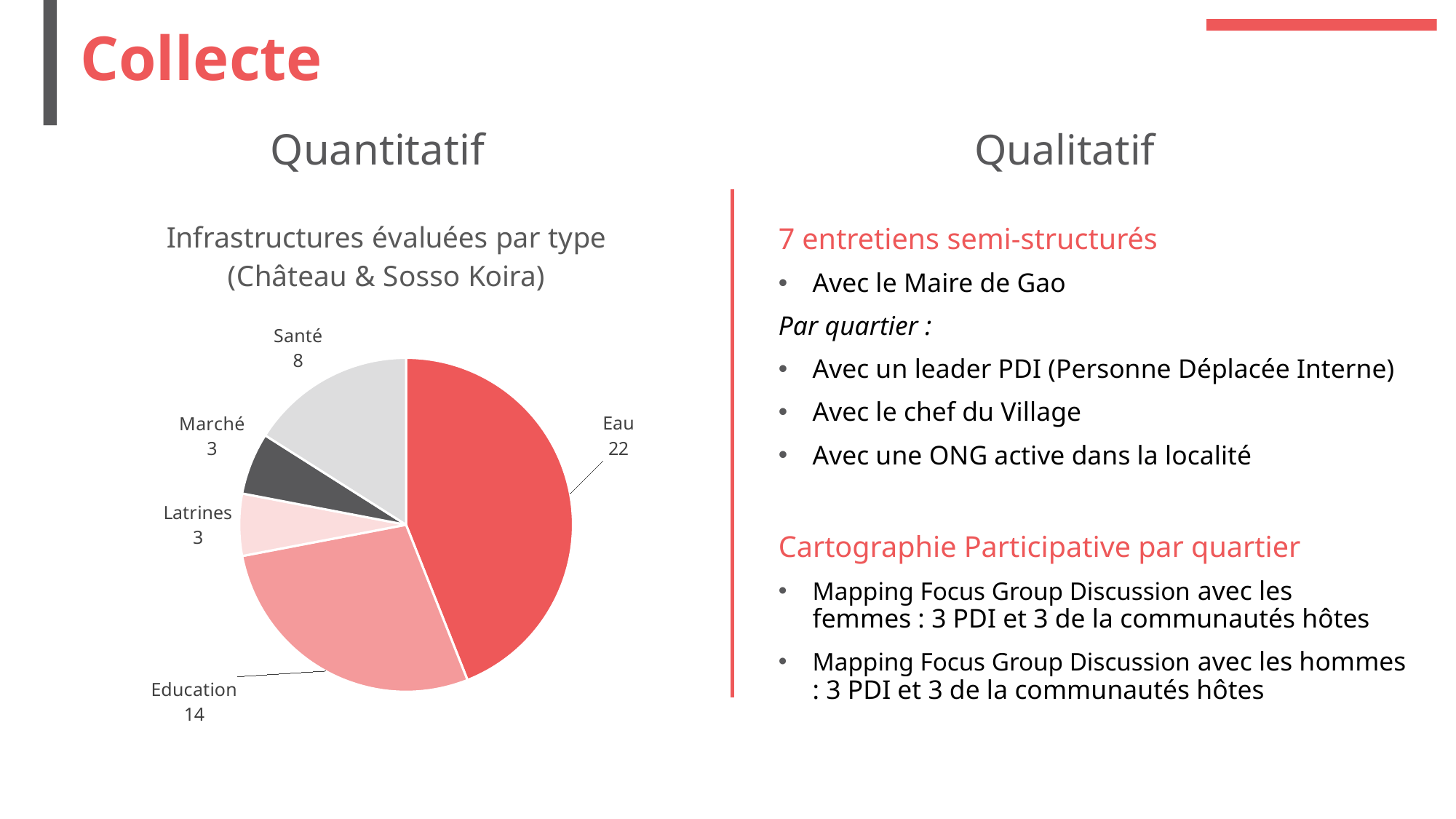
What share of the pie does Eau represent? 44% What is the value for Santé? 8 How many categories does the pie chart show? 5 Which category has the highest value? Eau What is the total of all the values in the pie chart? 50 What is the value for Latrines? 3 What is the value for Education? 14 Which is larger, the value for Santé or the value for Marché? Santé What kind of chart is shown on the slide? pie chart What is the title of the chart? Infrastructures évaluées par type (Château & Sosso Koira) What is the value for Eau? 22 What is the difference between the values for Eau and Education? 8